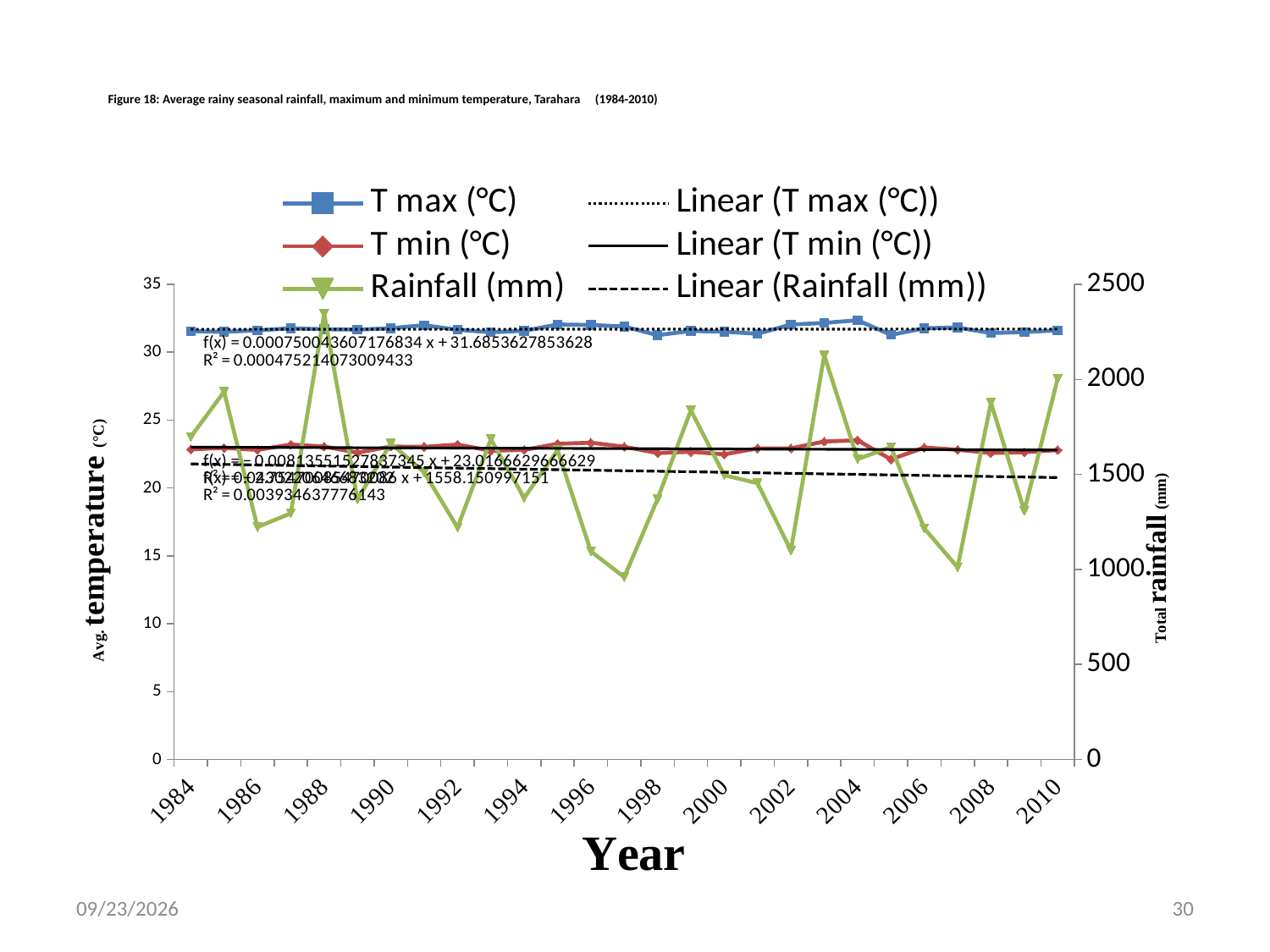
Does the linear trendline for Rainfall (mm) rise or fall from 1984 to 2010? fall What kind of chart is shown on the slide? Line chart Is the rainfall value for 1986 greater or less than 1500 mm? less Which is larger in 1988, the rainfall or the rainfall in 1986? 1988 Is the rainfall value for 1988 greater or less than 2000 mm? greater Is the T max value for 1984 greater or less than 30 °C? greater How many entries does the chart legend list? 6 Which series has higher values throughout the chart, T max (°C) or T min (°C)? T max (°C) What is the label of the right-hand vertical axis of the chart? Total rainfall (mm) Which year has the highest rainfall in the chart? 1988 How many years are labeled on the x axis of the chart? 14